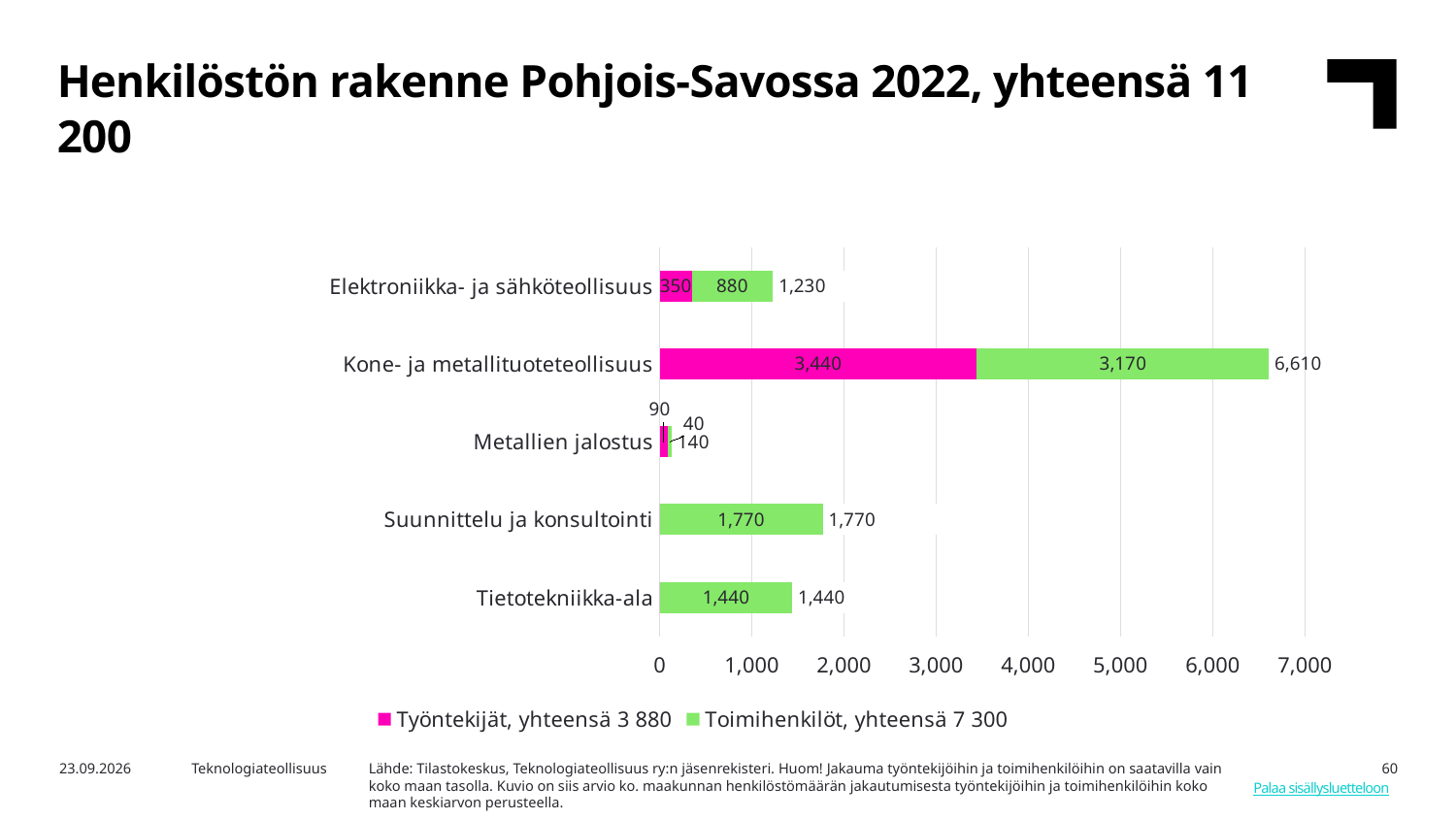
Which category has the highest total? Kone- ja metallituoteteollisuus What is the difference between the Toimihenkilöt values for Suunnittelu ja konsultointi and Tietotekniikka-ala? 330 What is the Toimihenkilöt value for Elektroniikka- ja sähköteollisuus? 880 How many series does the legend list? 2 How many categories are shown on the chart? 5 Which is larger for Kone- ja metallituoteteollisuus: the Työntekijät value or the Toimihenkilöt value? Työntekijät What kind of chart is shown on the slide? Stacked bar chart What total is given in the legend for Toimihenkilöt? 7 300 Is the total for Elektroniikka- ja sähköteollisuus greater or less than 1,000? greater What is the total shown for the Kone- ja metallituoteteollisuus bar? 6,610 What is the Työntekijät value for Kone- ja metallituoteteollisuus? 3,440 Which category has the lowest total? Metallien jalostus